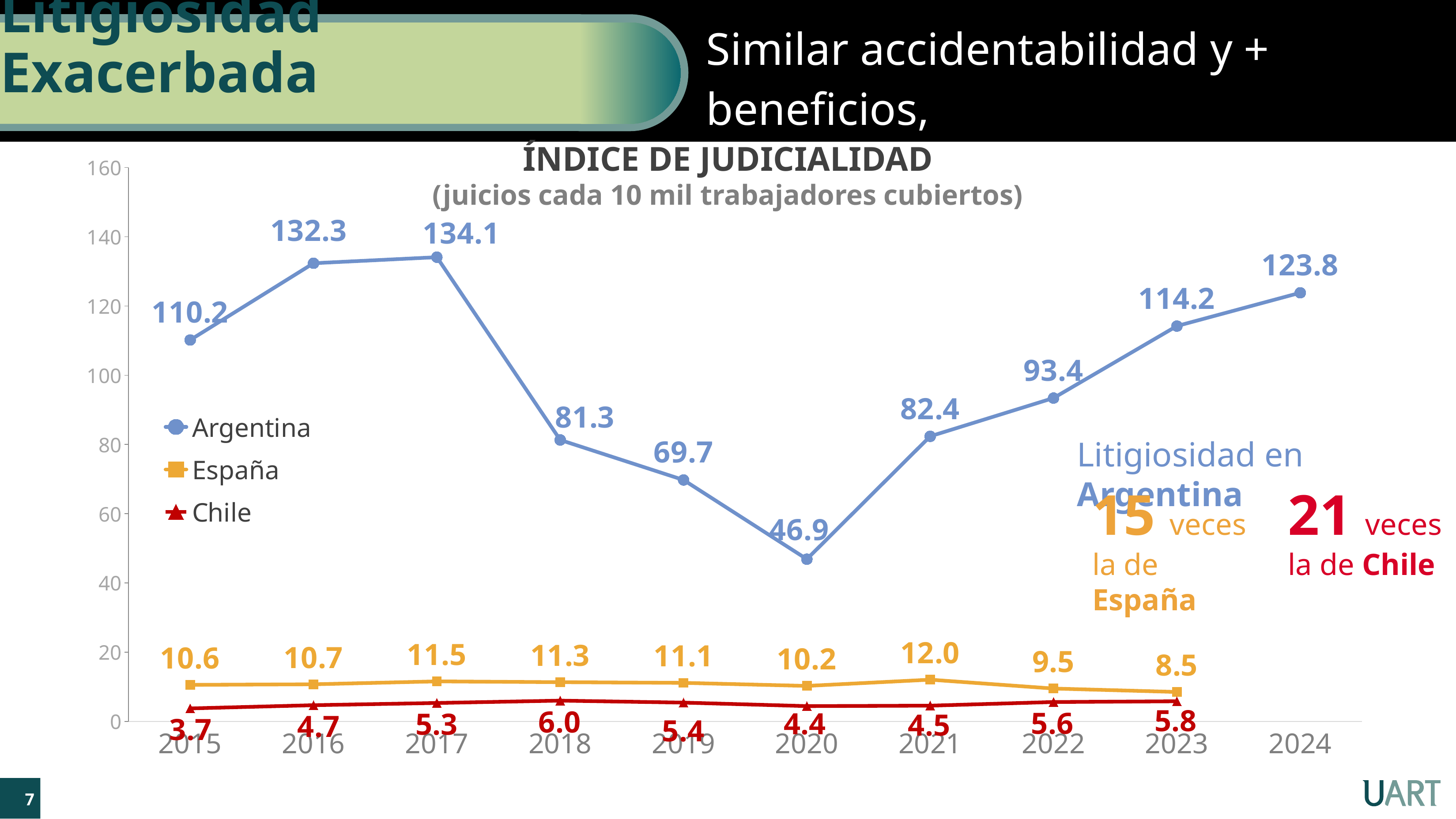
Does the Argentina series rise or fall from 2020 to 2024? rise What type of chart is shown on the slide? line chart What is the value for Chile in 2018? 6.0 In which year is the Argentina series at its highest? 2017 What is the value for Argentina in 2017? 134.1 Is the value for Argentina in 2022 greater or less than 100? less Which is larger, the España value in 2015 or the España value in 2023? 2015 How many series does the legend list? 3 In which year is the Argentina series at its lowest? 2020 What is the title of the chart? ÍNDICE DE JUDICIALIDAD What is the value for España in 2021? 12.0 What is the difference between the Argentina values for 2024 and 2023? 9.6